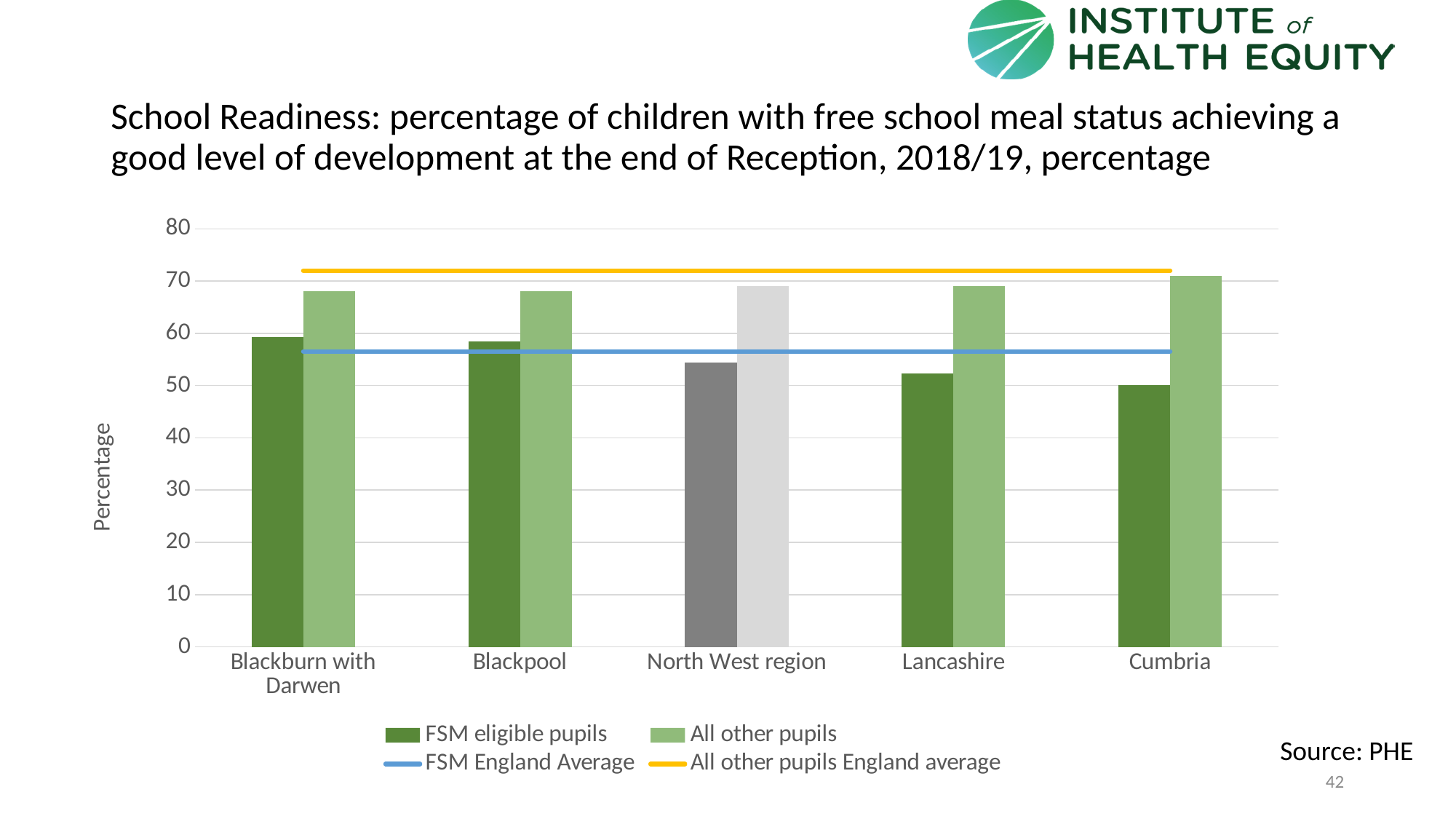
What is the source cited for the chart? PHE What kind of chart is shown on the slide? Combination bar and line chart How many areas (categories) are shown on the x axis? 5 Is the All other pupils England average line greater or less than 70? greater Is the FSM eligible pupils value for Blackburn with Darwen greater or less than 50? greater How many series does the legend list? 4 Which area has the lowest value for FSM eligible pupils? Cumbria Is the All other pupils value for Blackpool greater or less than 70? less Do the FSM eligible pupils values rise or fall from left to right across the x axis? fall Which is larger: the FSM eligible pupils value for Blackburn with Darwen or for Cumbria? Blackburn with Darwen Which area has the highest value for All other pupils? Cumbria